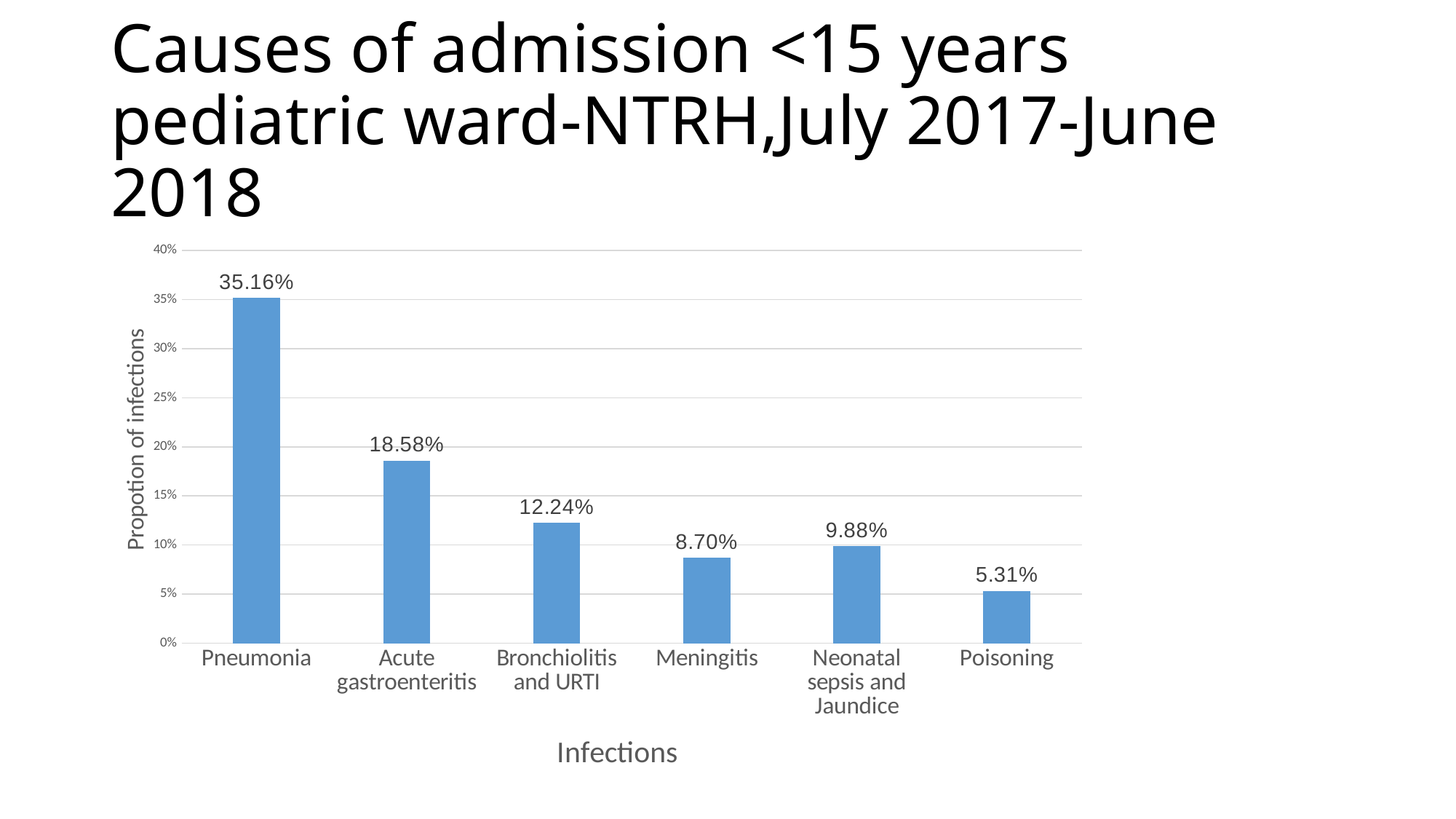
What is the difference in proportion between Pneumonia and Acute gastroenteritis? 16.58% What is the proportion of infections for Pneumonia? 35.16% Which has a larger proportion of infections, Meningitis or Neonatal sepsis and Jaundice? Neonatal sepsis and Jaundice What kind of chart is shown on the slide? Bar chart What is the proportion of infections for Acute gastroenteritis? 18.58% Which cause of admission has the lowest proportion of infections? Poisoning Is the value for Bronchiolitis and URTI greater or less than 10%? greater What is the proportion of infections for Poisoning? 5.31% What is the proportion of infections for Meningitis? 8.70% Which cause of admission has the highest proportion of infections? Pneumonia How many causes of admission are shown on the chart? 6 What is the label of the x axis? Infections